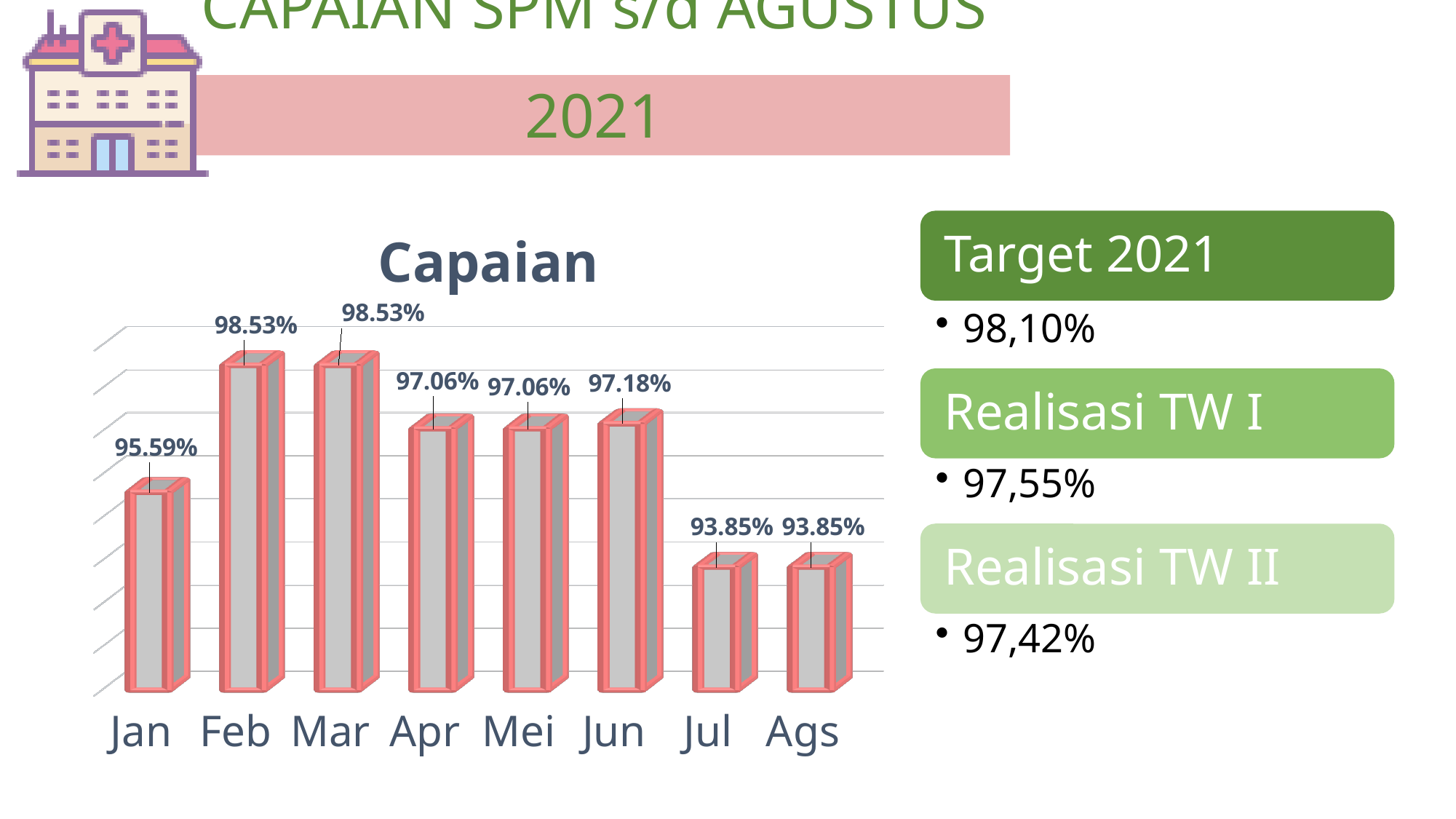
What is the value for Apr in the Capaian chart? 97.06% What is the difference between the values for Jan and Jul in the Capaian chart? 1.74 percentage points Which months share the lowest value in the Capaian chart? Jul and Ags What is the value for Jan in the Capaian chart? 95.59% What is the difference between the values for Feb and Jan in the Capaian chart? 2.94 percentage points What is the value for Ags in the Capaian chart? 93.85% How many months are shown in the Capaian chart? 8 Do the values in the Capaian chart rise or fall from Jun to Jul? Fall Which is larger in the Capaian chart, the value for Jun or the value for Apr? Jun What is the value for Jun in the Capaian chart? 97.18% Which months share the highest value in the Capaian chart? Feb and Mar What kind of chart is the Capaian chart? Bar chart